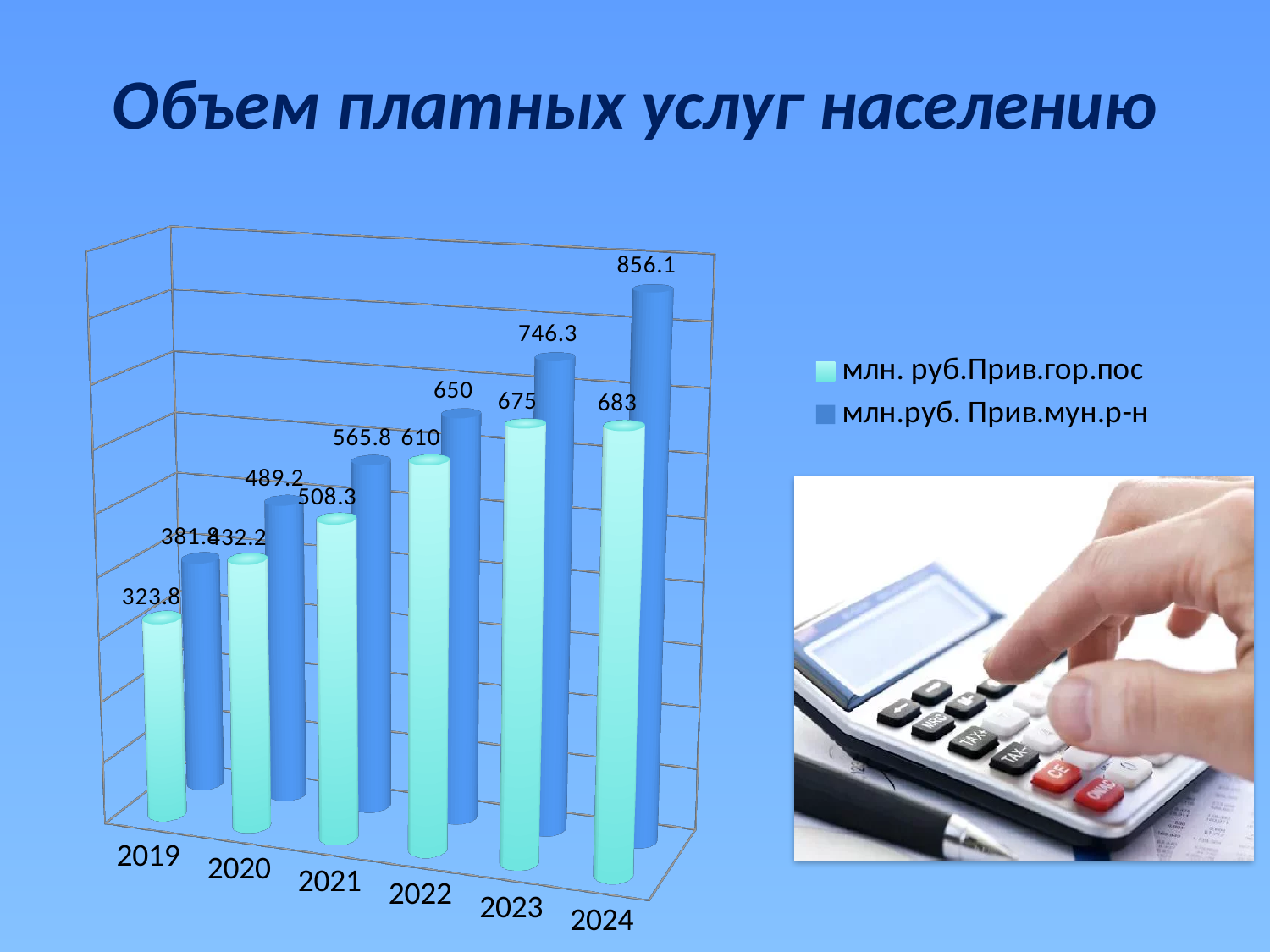
What kind of chart is shown on the slide? bar chart What is the value for млн.руб. Прив.мун.р-н in 2024? 856.1 In which year is the value for млн.руб. Прив.мун.р-н the highest? 2024 What is the value for млн.руб. Прив.мун.р-н in 2023? 746.3 In which year is the value for млн. руб.Прив.гор.пос the lowest? 2019 Which series has the larger value in 2021, млн. руб.Прив.гор.пос or млн.руб. Прив.мун.р-н? млн.руб. Прив.мун.р-н What is the value for млн. руб.Прив.гор.пос in 2022? 610 Do the values for млн.руб. Прив.мун.р-н rise or fall from 2019 to 2024? rise How many years are shown on the x axis of the chart? 6 What is the value for млн. руб.Прив.гор.пос in 2019? 323.8 What is the difference between млн.руб. Прив.мун.р-н and млн. руб.Прив.гор.пос in 2024? 173.1 How many series does the legend list? 2